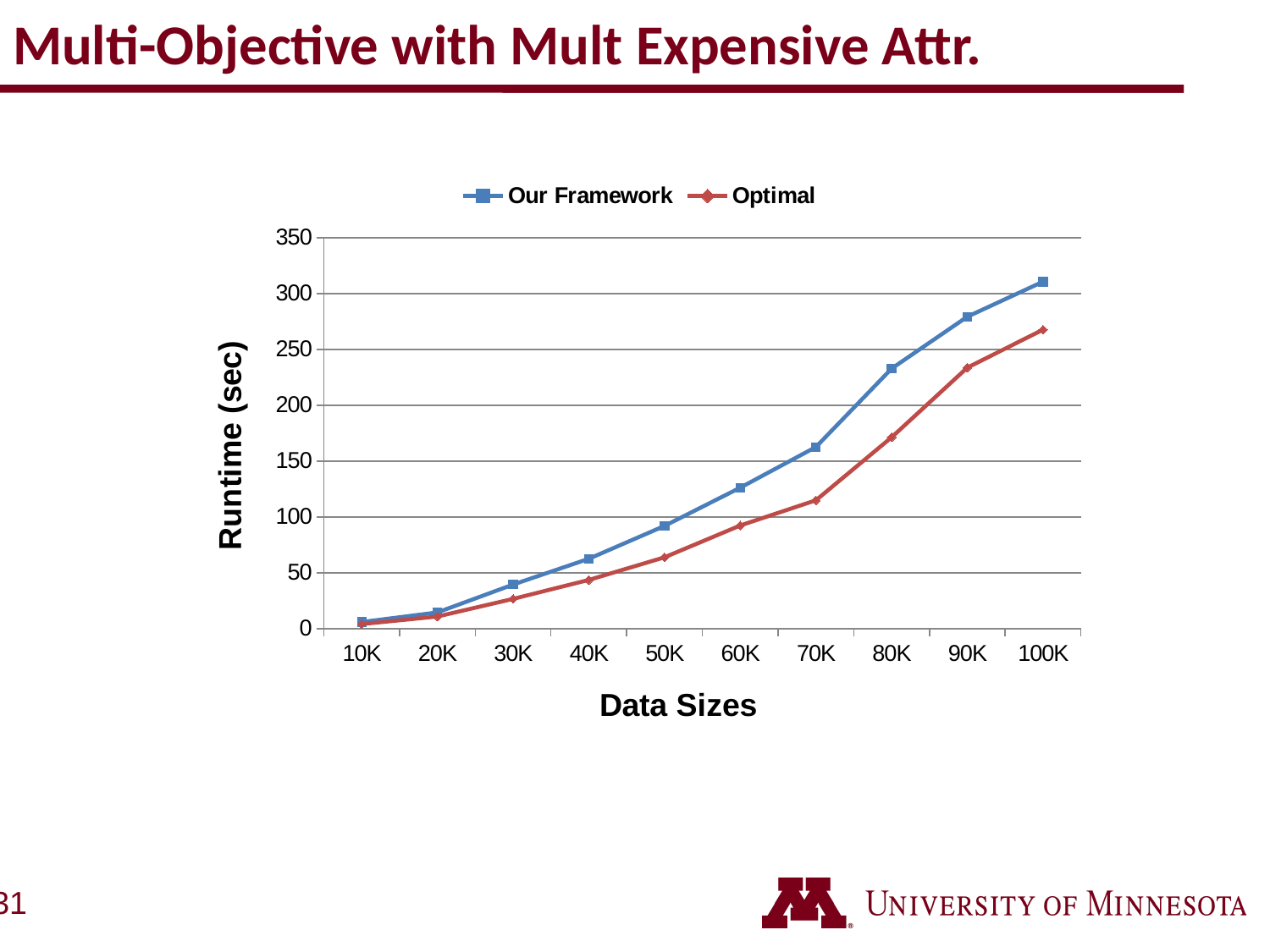
Is the value for Our Framework at 100K greater or less than 300? greater Is the value for Our Framework at 70K greater or less than 150? greater Do the runtimes rise or fall as the data size increases from 10K to 100K? rise Is the value for Optimal at 100K greater or less than 300? less How many data sizes are plotted along the x axis? 10 Which series is shown in blue in the legend? Our Framework At 100K, which series has the higher runtime, Our Framework or Optimal? Our Framework What is the label of the y axis? Runtime (sec) What kind of chart is shown on the slide? line chart At which data size does Our Framework reach its highest runtime? 100K How many series does the legend list? 2